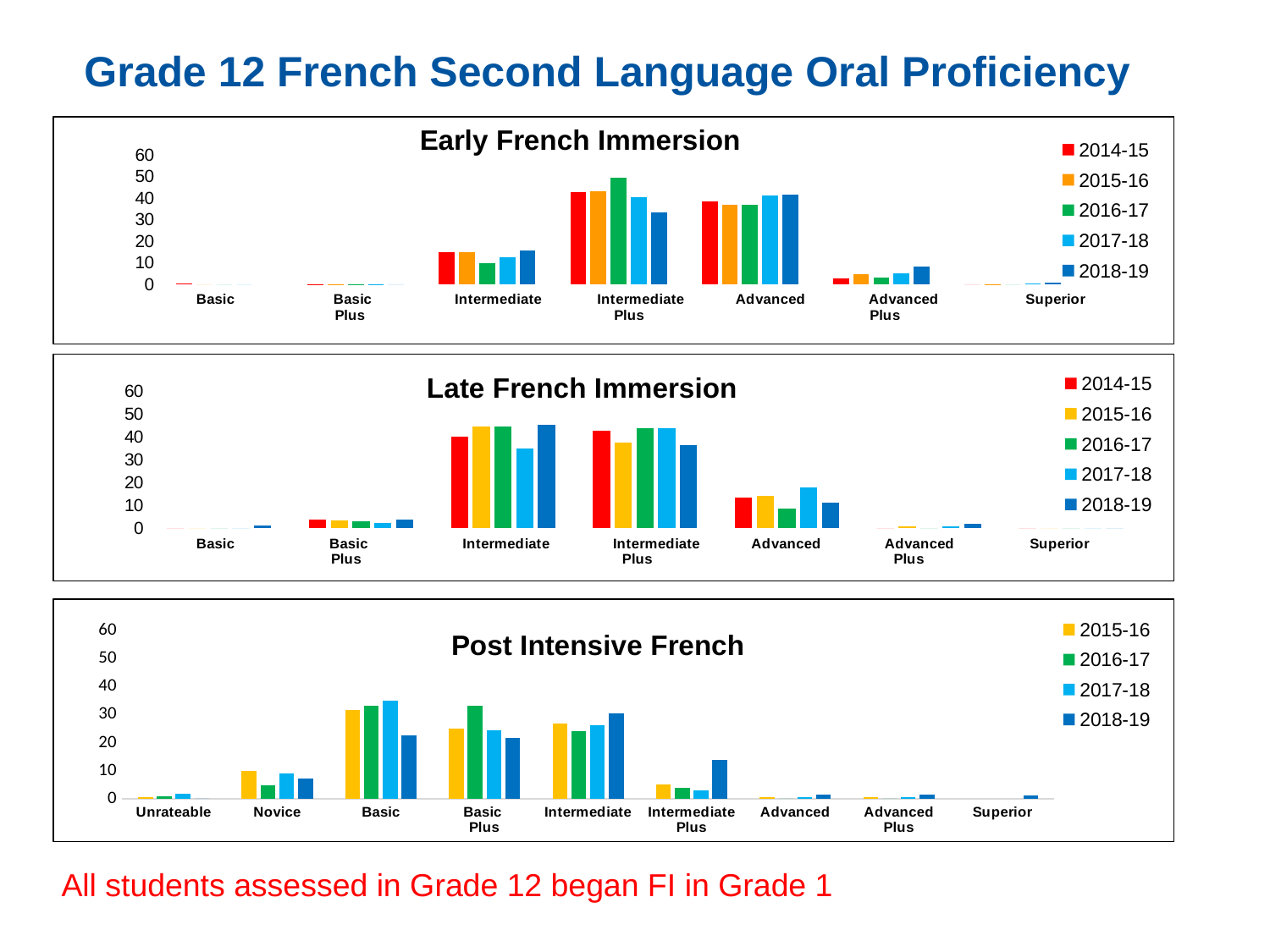
How many proficiency categories are shown on the x axis of the Early French Immersion chart? 7 How many series does the legend of the Early French Immersion chart list? 5 In the Late French Immersion chart, is the 2017-18 value for Intermediate greater or less than 40? less How many series does the legend of the Post Intensive French chart list? 4 What kind of chart is the Early French Immersion chart? bar chart In the Late French Immersion chart, which is larger for Intermediate: the 2017-18 value or the 2018-19 value? 2018-19 In the Early French Immersion chart, is the 2016-17 value for Intermediate greater or less than 20? less In the Early French Immersion chart, is the 2016-17 value for Intermediate Plus greater or less than 40? greater In the Early French Immersion chart, which year has the highest value for Intermediate Plus? 2016-17 In the Post Intensive French chart, which year has the lowest value for Basic? 2018-19 How many categories are shown on the x axis of the Post Intensive French chart? 9